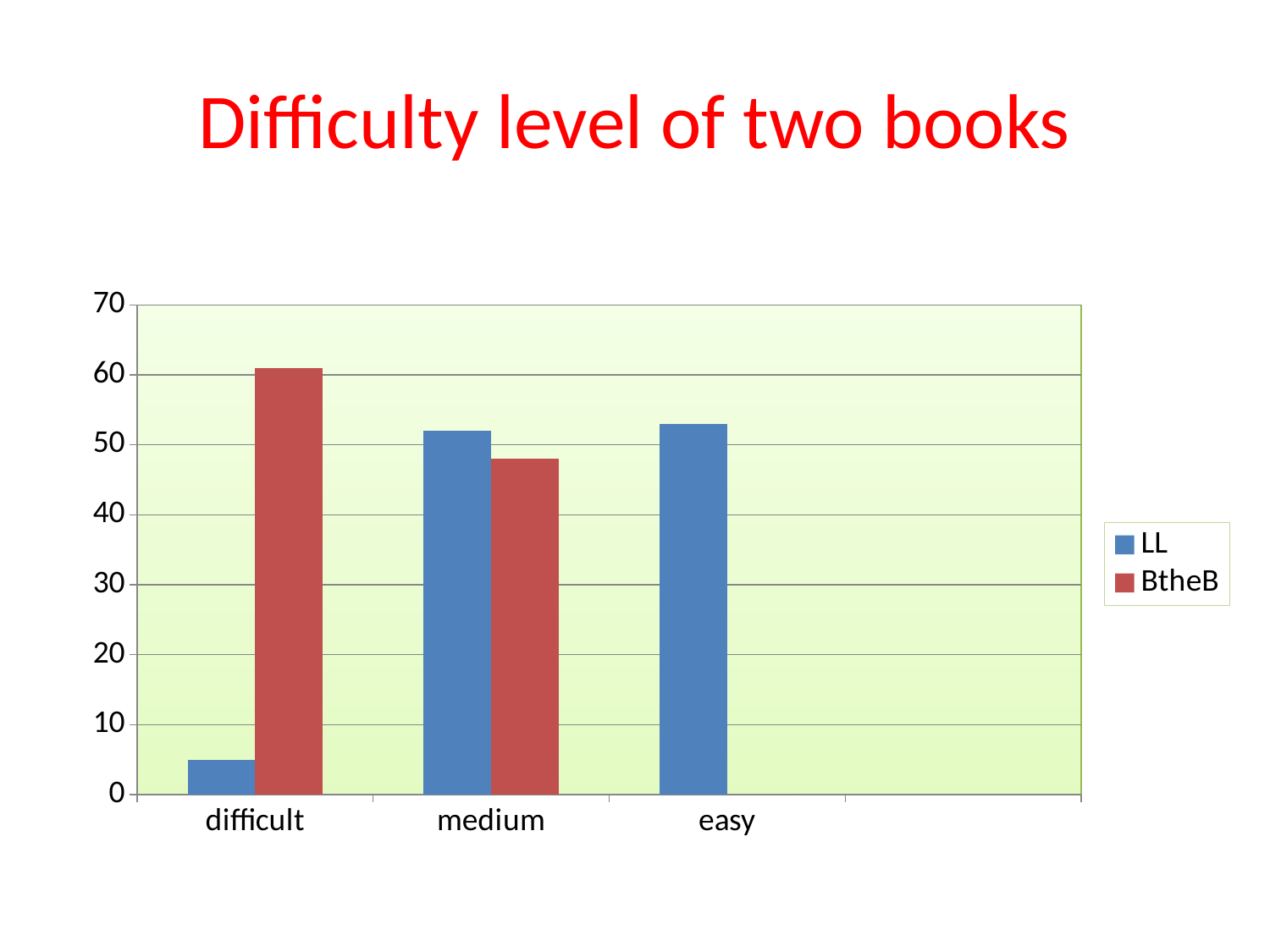
What is the title of the chart? Difficulty level of two books Which category has the highest value for the BtheB series? difficult Which series is shown in red? BtheB What kind of chart is shown on the slide? bar chart Is the value for LL in the difficult category greater or less than 10? less How many difficulty categories are shown on the x axis? 3 Which category has the lowest value for the LL series? difficult Is the value for BtheB in the medium category greater or less than 40? greater Is the value for BtheB in the difficult category greater or less than 50? greater How many series does the legend list? 2 For the medium category, which series has the larger value, LL or BtheB? LL For the difficult category, which series has the larger value, LL or BtheB? BtheB